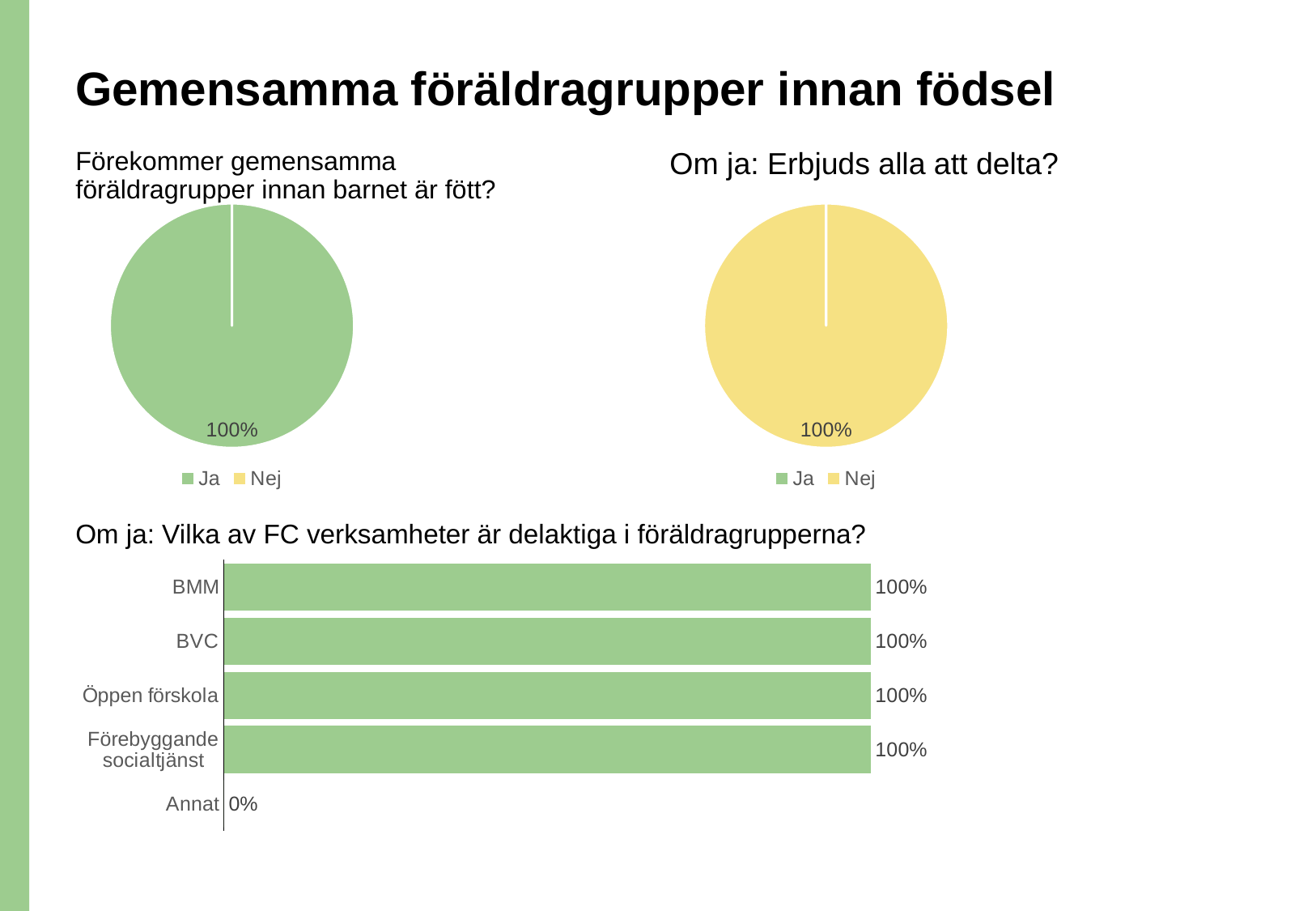
In the pie chart titled 'Om ja: Erbjuds alla att delta?', which legend entry does the single slice belong to? Nej In the bar chart titled 'Om ja: Vilka av FC verksamheter är delaktiga i föräldragrupperna?', how many categories are shown? 5 In the bar chart titled 'Om ja: Vilka av FC verksamheter är delaktiga i föräldragrupperna?', which is larger, the value for Öppen förskola or the value for Annat? Öppen förskola In the bar chart titled 'Om ja: Vilka av FC verksamheter är delaktiga i föräldragrupperna?', which category has the lowest value? Annat What kind of chart is the chart titled 'Om ja: Vilka av FC verksamheter är delaktiga i föräldragrupperna?'? bar chart What kind of chart is the chart titled 'Om ja: Erbjuds alla att delta?'? pie chart In the bar chart titled 'Om ja: Vilka av FC verksamheter är delaktiga i föräldragrupperna?', what is the value for Annat? 0% In the pie chart titled 'Förekommer gemensamma föräldragrupper innan barnet är fött?', how many series does the legend list? 2 In the pie chart titled 'Förekommer gemensamma föräldragrupper innan barnet är fött?', what share does the Ja slice have? 100% In the pie chart titled 'Om ja: Erbjuds alla att delta?', what share does the Nej slice have? 100% In the bar chart titled 'Om ja: Vilka av FC verksamheter är delaktiga i föräldragrupperna?', what is the value for BVC? 100% In the bar chart titled 'Om ja: Vilka av FC verksamheter är delaktiga i föräldragrupperna?', what is the difference between the values for BMM and Annat? 100%